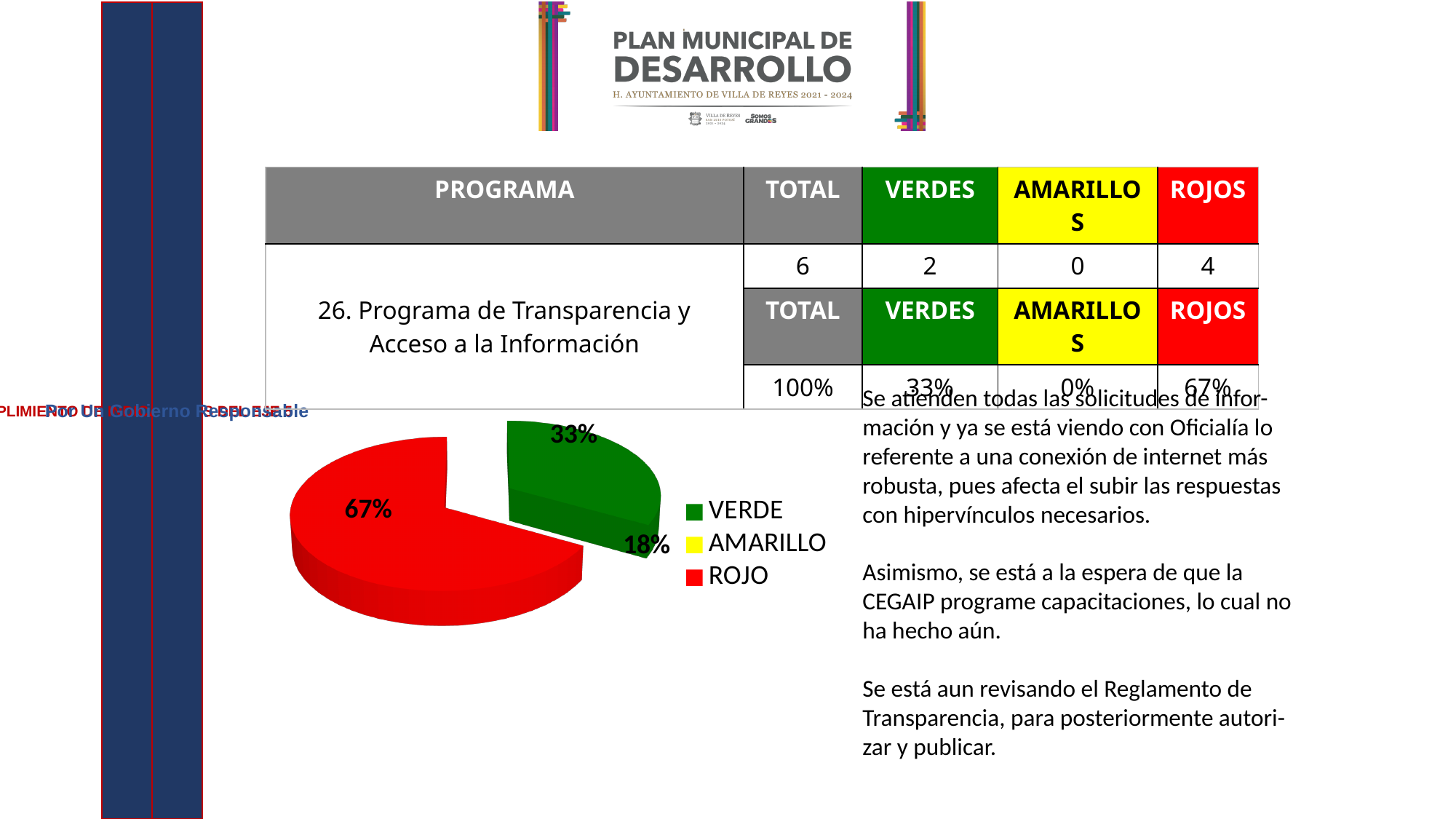
By how many percentage points does the ROJO slice exceed the VERDE slice? 34 Which category has the largest slice in the pie chart? ROJO What percentage does the pie chart show for ROJO? 67% Which slice is larger in the pie chart, VERDE or ROJO? ROJO What percentage does the pie chart show for VERDE? 33% How many entries does the pie chart's legend list? 3 What colour is the ROJO slice in the pie chart? red Which legend entry is shown in green in the pie chart? VERDE What kind of chart is shown on the slide? pie chart